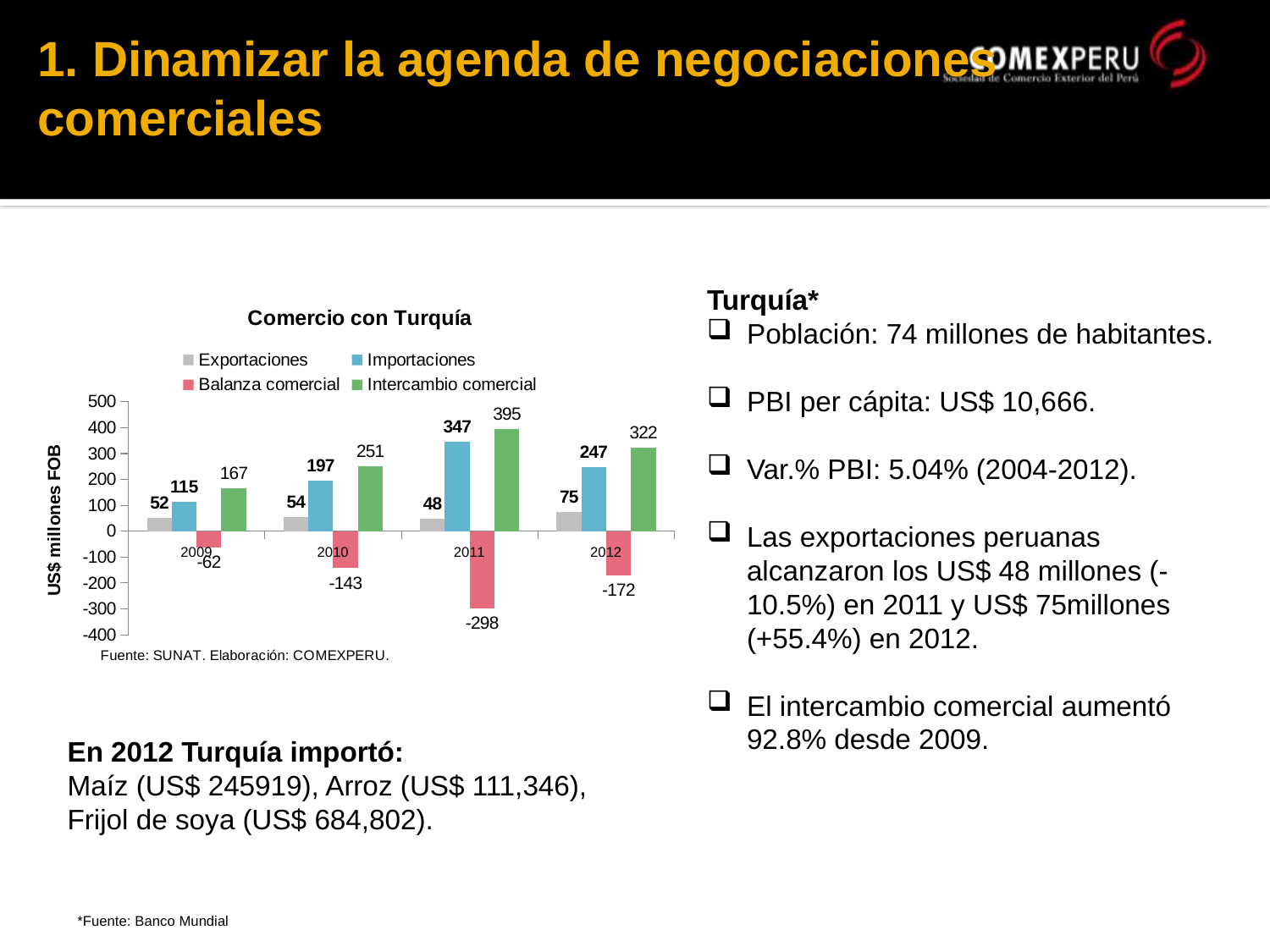
What is the value of Exportaciones in 2012? 75 What is the value of Importaciones in 2011? 347 What is the difference between Importaciones in 2011 and Importaciones in 2010? 150 Which is larger: Intercambio comercial in 2012 or Intercambio comercial in 2010? Intercambio comercial in 2012 How many years are shown on the x axis? 4 What is the value of Intercambio comercial in 2009? 167 In which year is Exportaciones lowest? 2011 What kind of chart is shown? Bar chart In which year is Intercambio comercial highest? 2011 How many series does the legend list? 4 What is the value of Balanza comercial in 2010? -143 What is the title of the chart? Comercio con Turquía